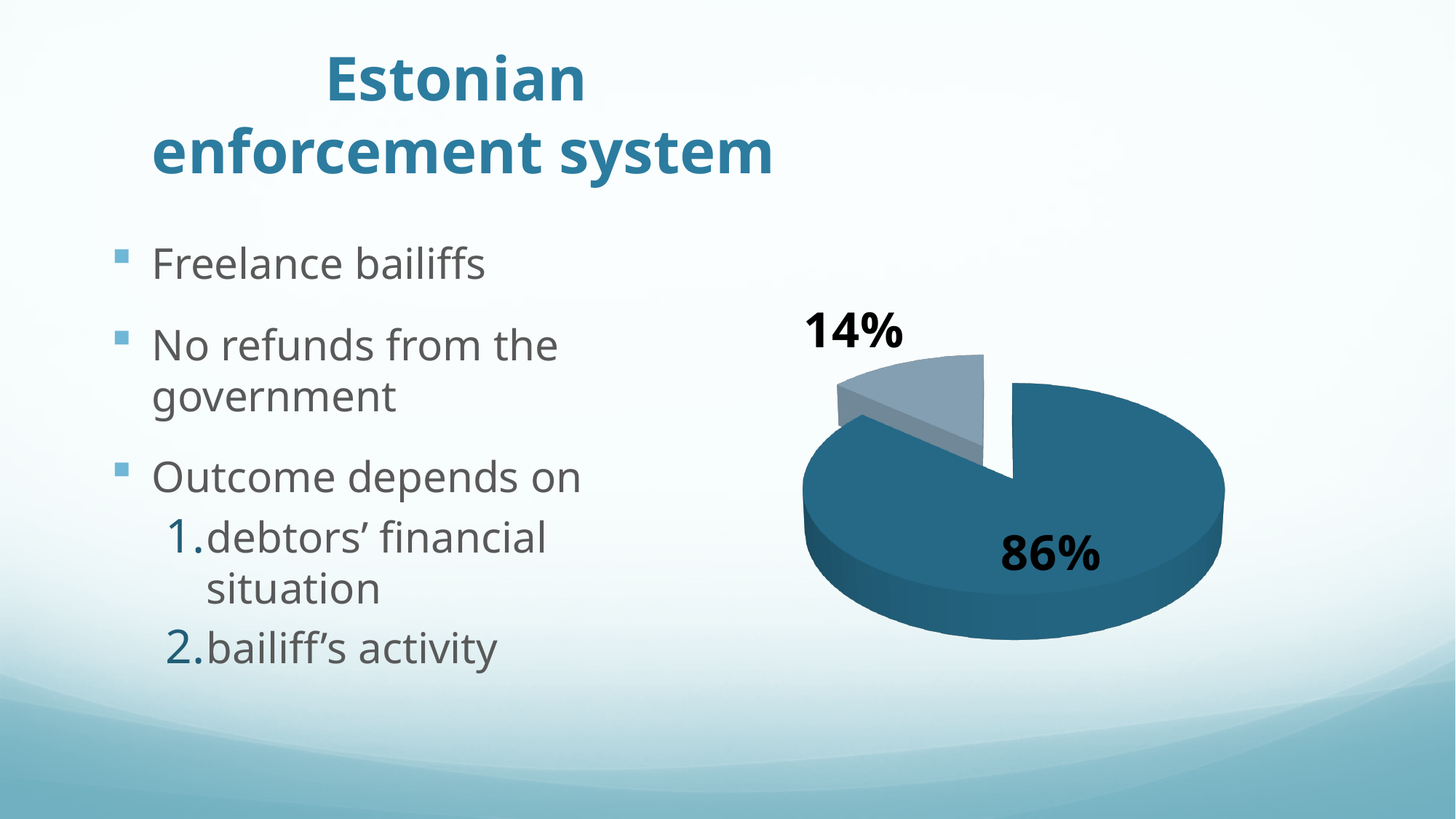
Is the value of the light grey slice greater or less than 20%? less Is the value of the dark teal slice greater or less than 80%? greater How many slices does the pie chart have? 2 What percentage is shown on the small light grey slice of the pie chart? 14% What kind of chart is shown on the slide? pie chart Which slice of the pie chart is larger, the dark teal one or the light grey one? the dark teal one What is the share of the largest slice in the pie chart? 86% What is the share of the smallest slice in the pie chart? 14% What do the two slices of the pie chart add up to? 100% Which slice of the pie chart is pulled out (exploded) from the rest of the pie? the 14% slice What percentage is shown on the large dark teal slice of the pie chart? 86% What is the difference in percentage points between the two slices of the pie chart? 72